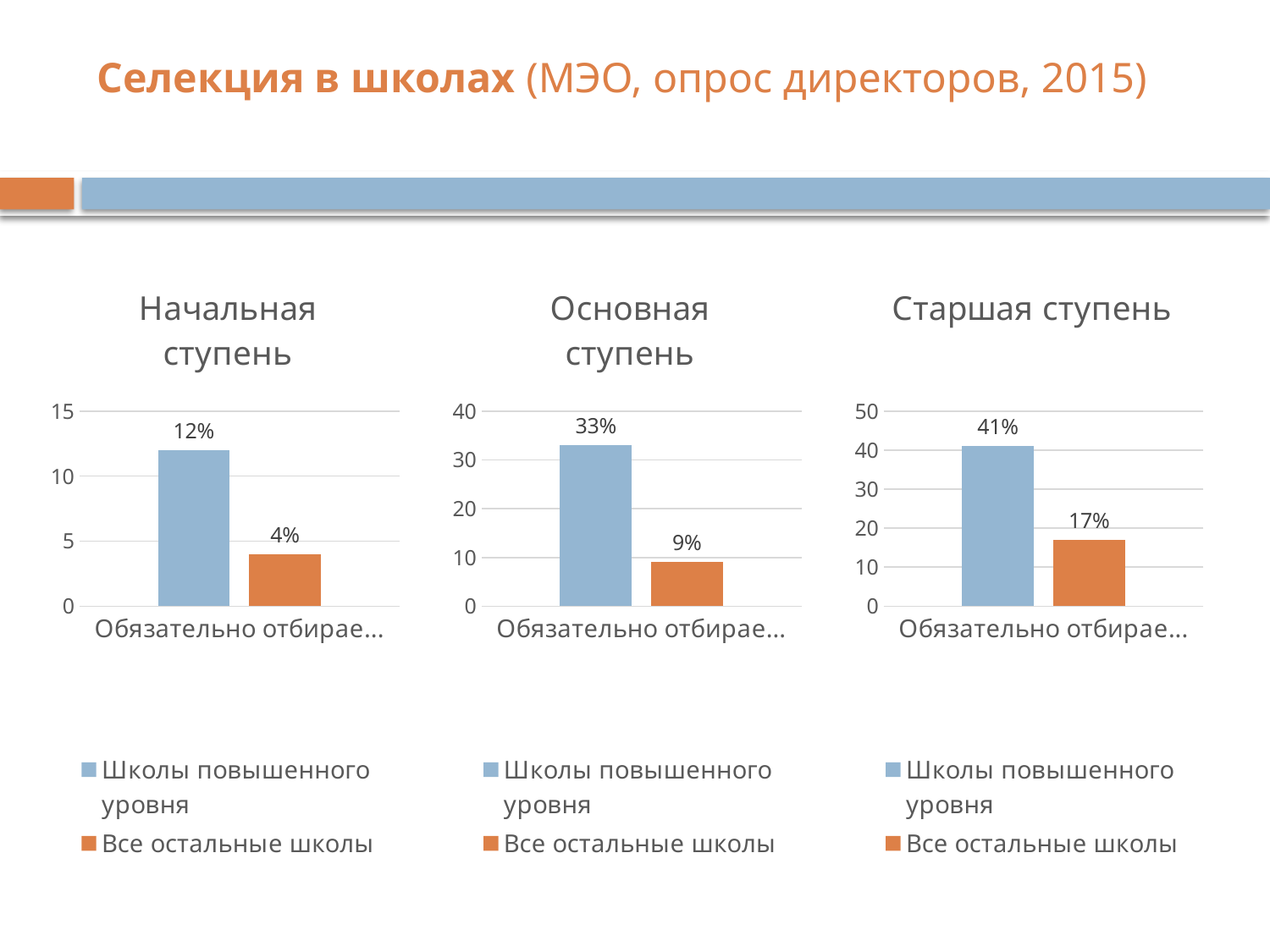
In the chart titled "Старшая ступень", what is the difference between the values for "Школы повышенного уровня" and "Все остальные школы"? 24% In the chart titled "Основная ступень", what is the value for "Все остальные школы"? 9% In the chart titled "Основная ступень", which series has the larger value: "Школы повышенного уровня" or "Все остальные школы"? Школы повышенного уровня In the chart titled "Начальная ступень", what is the value for "Школы повышенного уровня"? 12% In the chart titled "Старшая ступень", what is the value for "Школы повышенного уровня"? 41% In the chart titled "Старшая ступень", what is the value for "Все остальные школы"? 17% What kind of chart is the chart titled "Основная ступень"? bar chart In the chart titled "Основная ступень", what is the value for "Школы повышенного уровня"? 33% In the chart titled "Начальная ступень", is the value for "Школы повышенного уровня" greater or less than 10? greater In the chart titled "Начальная ступень", what is the value for "Все остальные школы"? 4% In the chart titled "Начальная ступень", what colour are the bars for "Все остальные школы"? orange How many series does the legend of the chart titled "Старшая ступень" list? 2